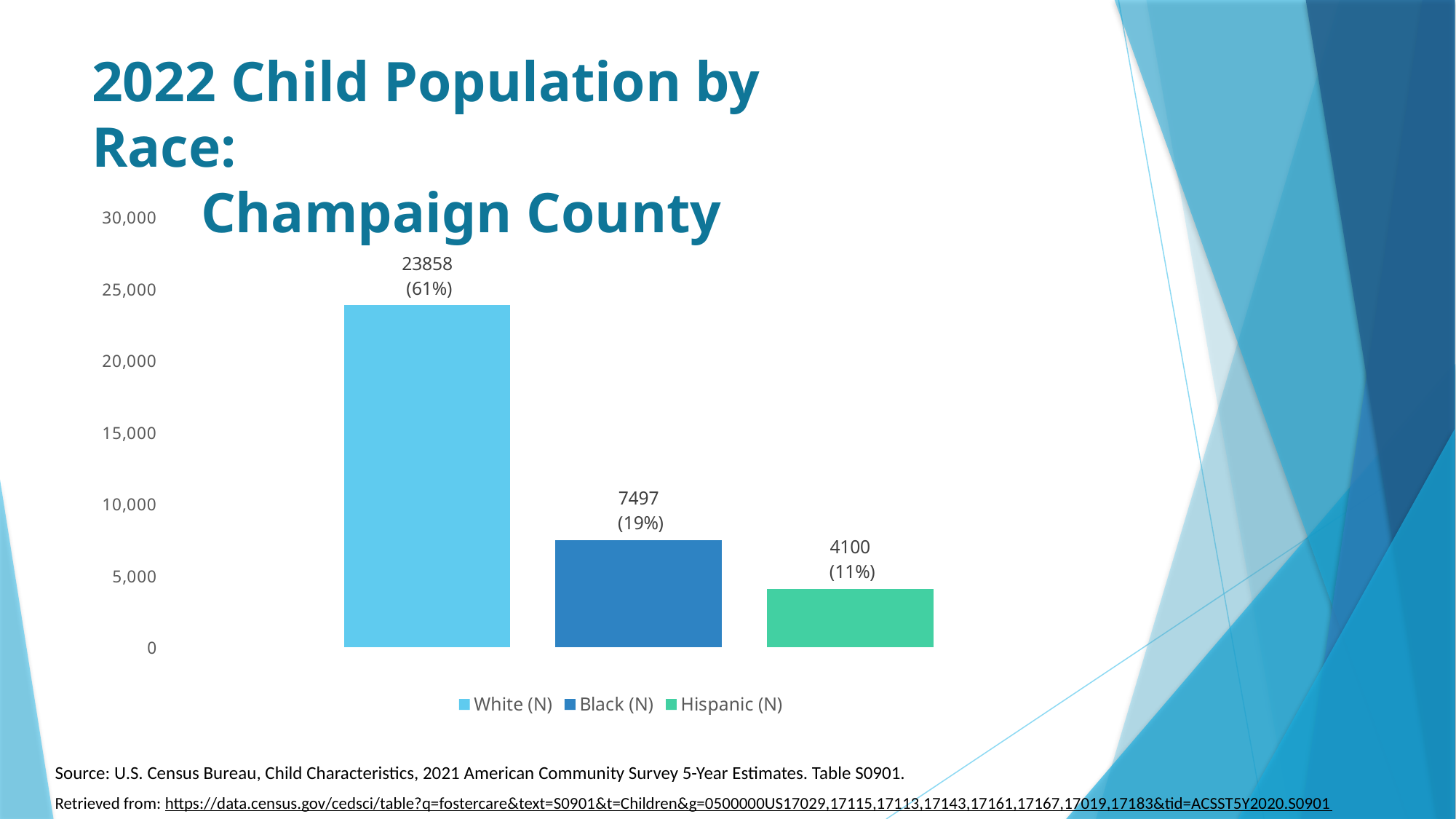
What is the difference between the values for White (N) and Black (N)? 16361 What kind of chart is shown on the slide? Bar chart How many series does the legend list? 3 Which is larger, the value for Black (N) or Hispanic (N)? Black (N) What is the value for White (N)? 23858 Which group has the lowest child population? Hispanic (N) What is the title of the chart? 2022 Child Population by Race: Champaign County What is the value for Hispanic (N)? 4100 What is the value for Black (N)? 7497 Which group has the highest child population? White (N) What is the difference between the values for Black (N) and Hispanic (N)? 3397 What percentage is shown for Black (N)? 19%